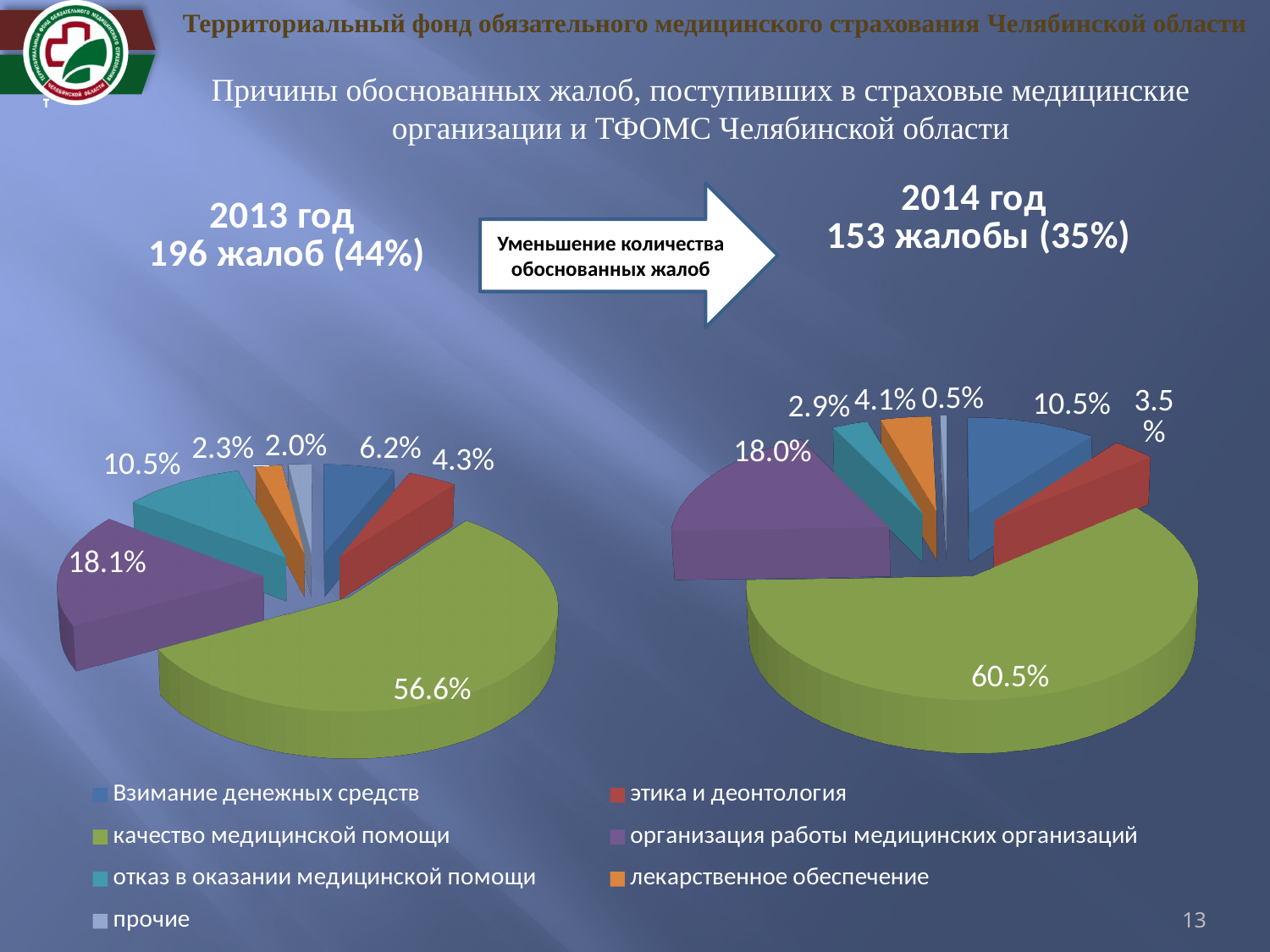
In the 2014 год pie chart, which category has the smallest slice? прочие In the 2014 год pie chart, what share is labelled for Взимание денежных средств? 10.5% In the 2013 год pie chart, what share is labelled for качество медицинской помощи? 56.6% What is the difference between the share for качество медицинской помощи in the 2014 год chart and in the 2013 год chart? 3.9% How many complaints are stated for 2014 год above the right pie chart? 153 жалобы (35%) In the 2014 год pie chart, what share is labelled for прочие? 0.5% In the 2013 год pie chart, which category has the largest slice? качество медицинской помощи In the 2014 год pie chart, what share is labelled for качество медицинской помощи? 60.5% How many categories does the legend list for the pie charts? 7 In the 2013 год pie chart, what share is labelled for организация работы медицинских организаций? 18.1% What kind of charts are shown on the slide? Pie charts In the 2013 год pie chart, which is larger: the slice for отказ в оказании медицинской помощи or the slice for Взимание денежных средств? отказ в оказании медицинской помощи